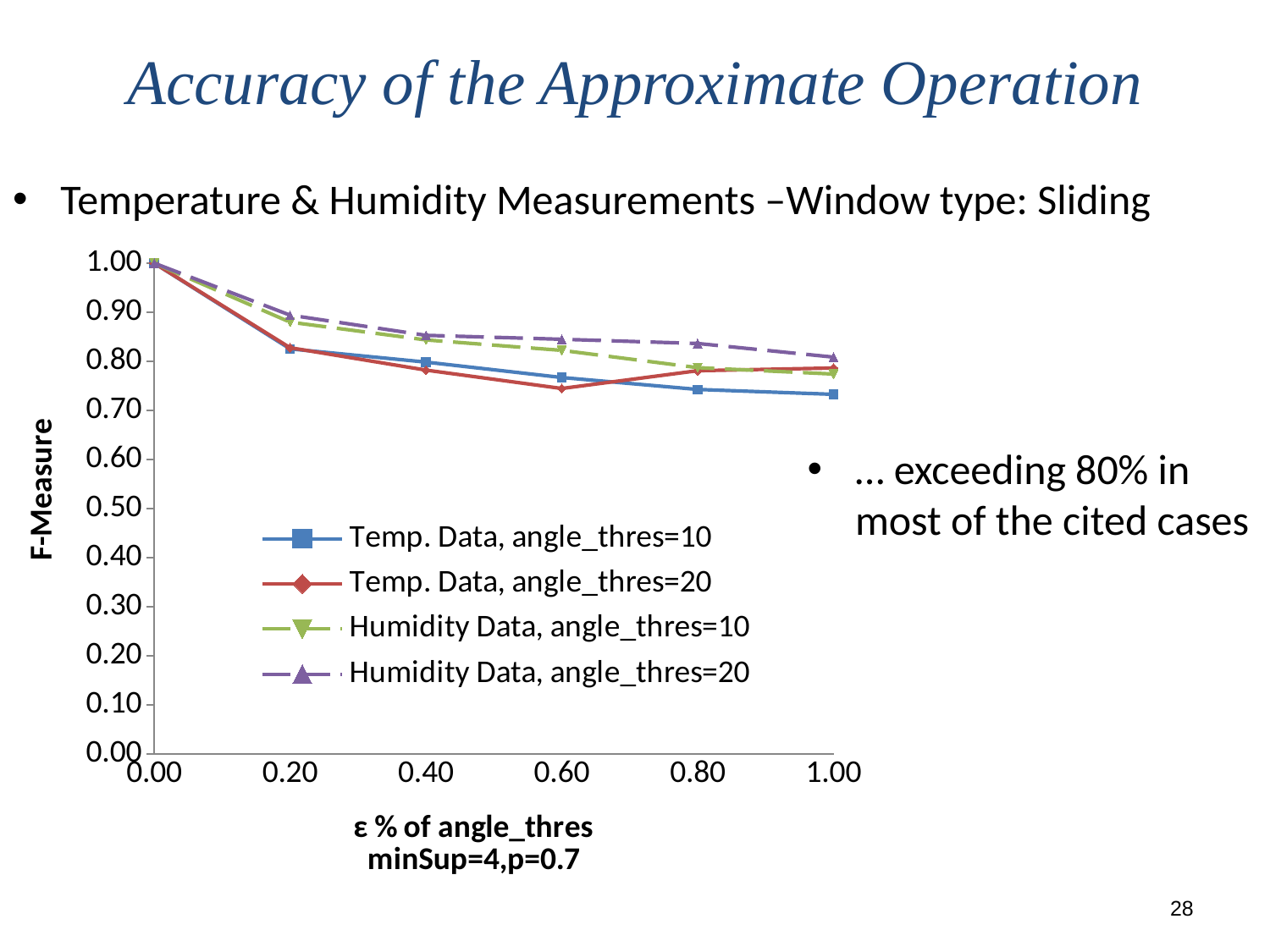
Is the value for Temp. Data, angle_thres=20 at ε = 0.60 greater or less than 0.80? less What is the F-Measure value for Humidity Data, angle_thres=20 at ε = 0.00? 1.00 Is the value for Temp. Data, angle_thres=10 at ε = 1.00 greater or less than 0.80? less What is the title of the chart's vertical axis? F-Measure How many series does the chart's legend list? 4 Does the F-Measure for Temp. Data, angle_thres=10 rise or fall as ε increases from 0.00 to 1.00? fall Is the value for Humidity Data, angle_thres=20 at ε = 0.40 greater or less than 0.80? greater What kind of chart is shown on the slide? line chart At ε = 0.60, which is larger: the F-Measure for Humidity Data, angle_thres=20 or for Temp. Data, angle_thres=20? Humidity Data, angle_thres=20 Which series has the lowest F-Measure at ε = 1.00? Temp. Data, angle_thres=10 How many data points are plotted for the Temp. Data, angle_thres=10 series? 6 Which series has the highest F-Measure at ε = 1.00? Humidity Data, angle_thres=20